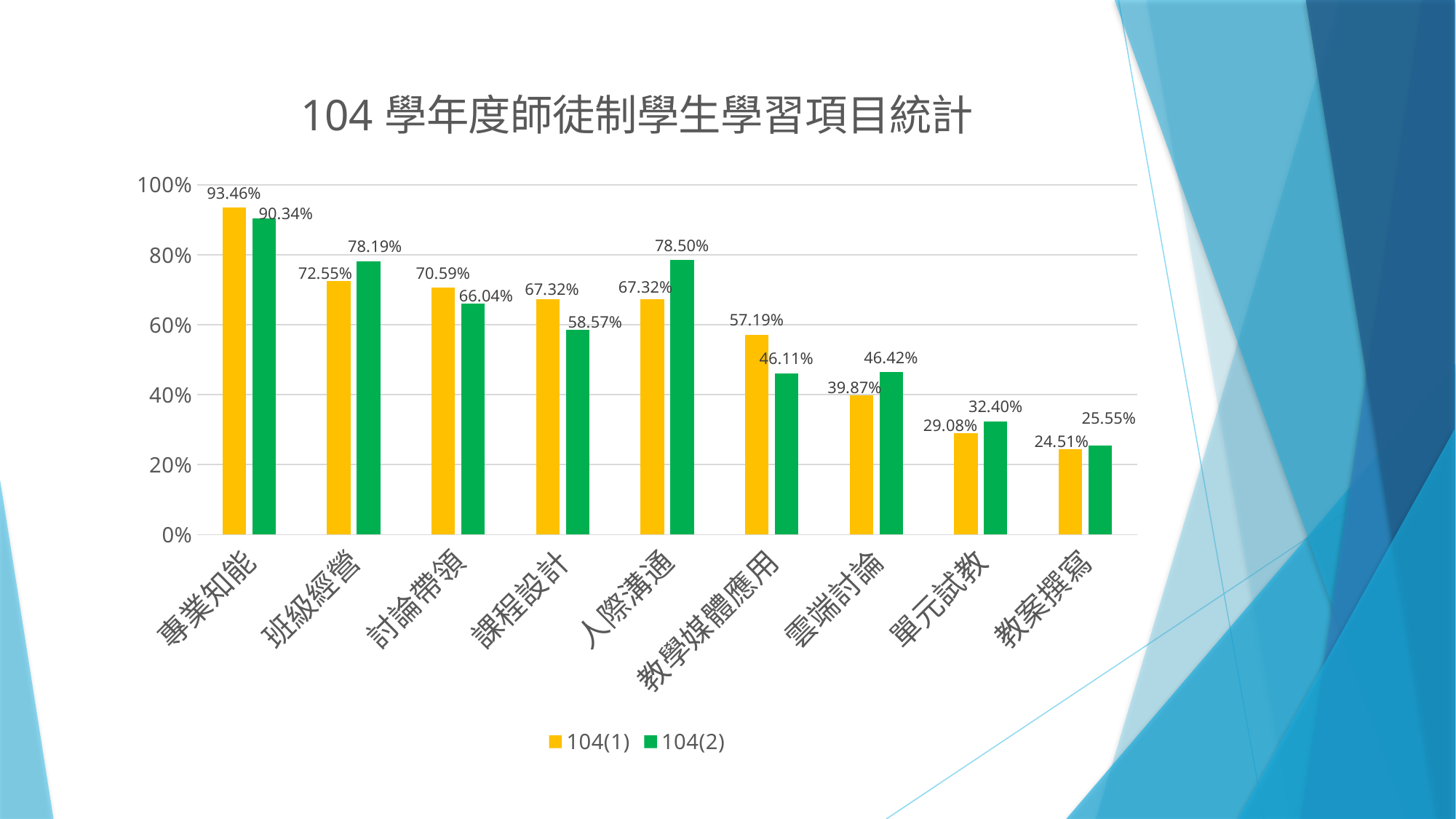
Which category has the lowest value in the 104(1) series? 教案撰寫 What is the title of the chart? 104 學年度師徒制學生學習項目統計 How many series does the legend list? 2 What kind of chart is shown on the slide? bar chart Which category has the highest value in the 104(2) series? 專業知能 What is the value for 人際溝通 in the 104(2) series? 78.50% What is the value for 專業知能 in the 104(1) series? 93.46% For 雲端討論, which series has the larger value, 104(1) or 104(2)? 104(2) Is the 104(2) value for 教學媒體應用 greater or less than 60%? less What is the value for 教案撰寫 in the 104(1) series? 24.51% What is the difference between the 104(1) and 104(2) values for 課程設計? 8.75% How many categories are shown on the x axis? 9